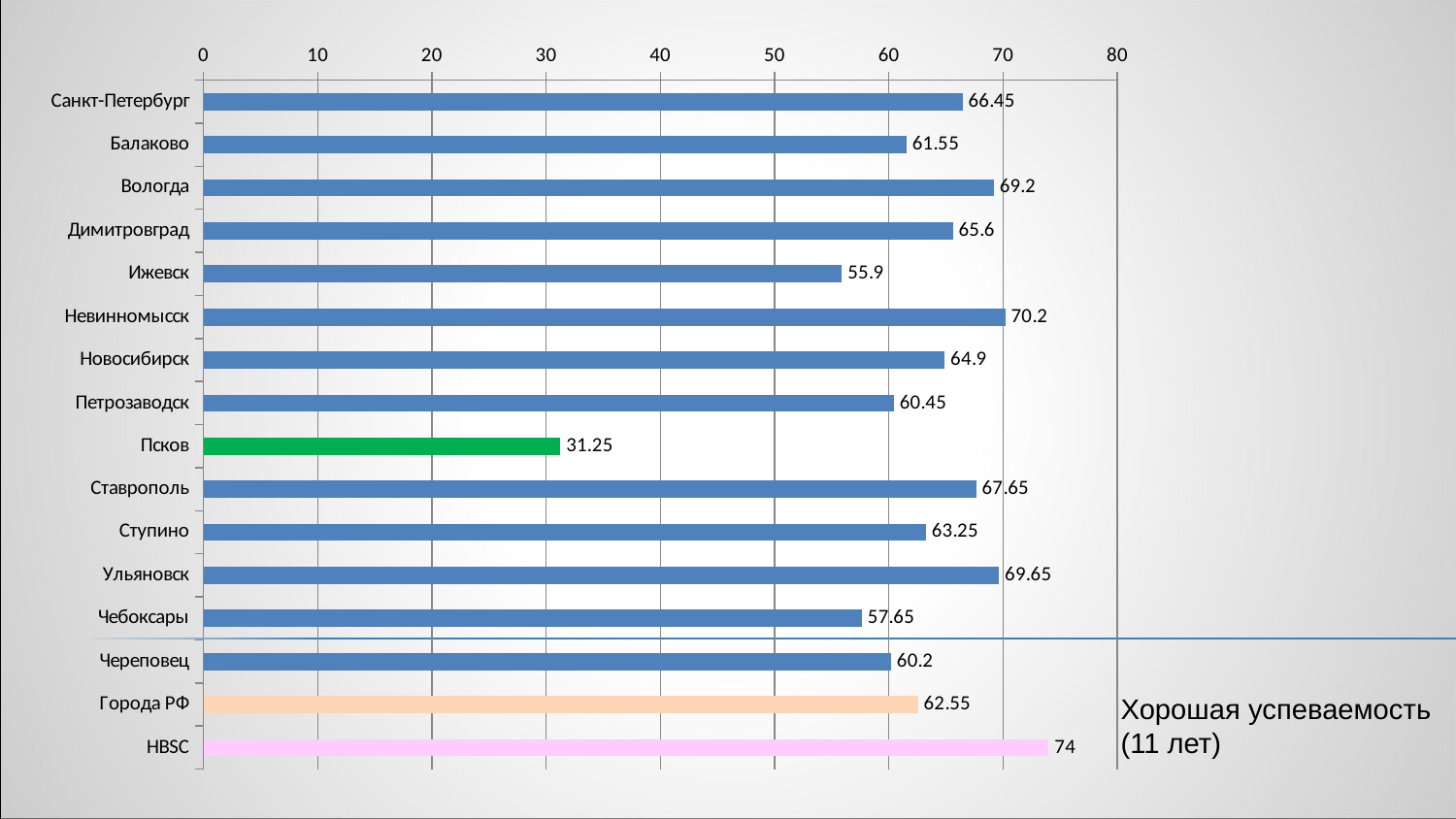
What is the value for Псков? 31.25 How many categories are shown in the chart? 16 What is the difference between the values for HBSC and Города РФ? 11.45 What is the value for HBSC? 74 What is the difference between the values for Невинномысск and Ижевск? 14.3 What kind of chart is shown on the slide? Bar chart What is the value for Города РФ? 62.55 What is the title text shown next to the chart? Хорошая успеваемость (11 лет) Which category has the lowest value? Псков What is the value for Невинномысск? 70.2 Which category has the highest value? HBSC Which has a larger value, Вологда or Ульяновск? Ульяновск